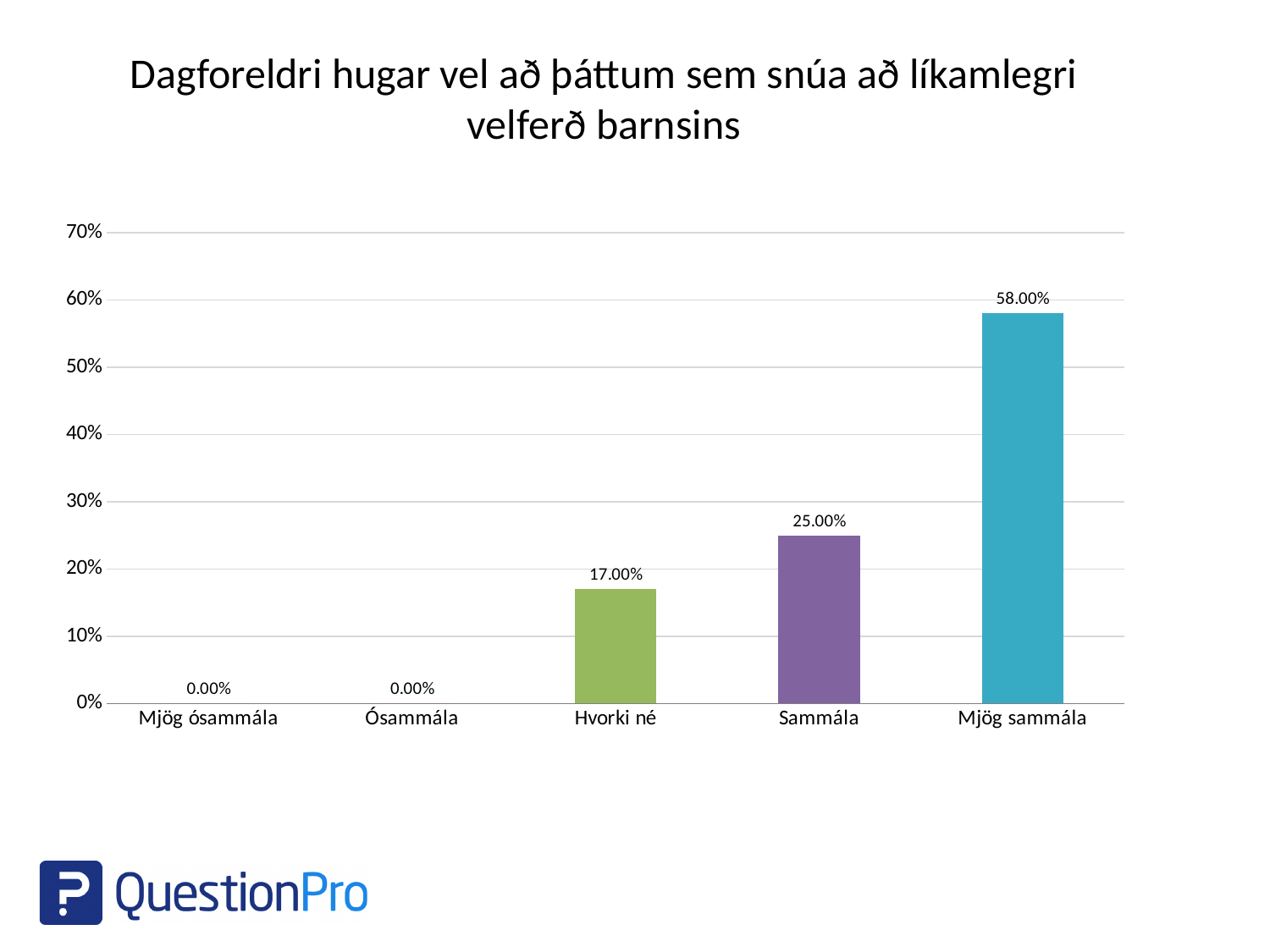
What is the value for Mjög sammála? 58.00% What is the difference between the values for Mjög sammála and Sammála? 33.00% Is the value for Mjög sammála greater or less than 50%? greater What is the value for Sammála? 25.00% What is the value for Ósammála? 0.00% What kind of chart is shown on the slide? bar chart Which is larger, the value for Hvorki né or the value for Sammála? Sammála Which category has the highest value? Mjög sammála What is the value for Hvorki né? 17.00% How many categories are shown on the x axis? 5 Do the values rise or fall from left to right along the x axis? rise What is the difference between the values for Sammála and Hvorki né? 8.00%